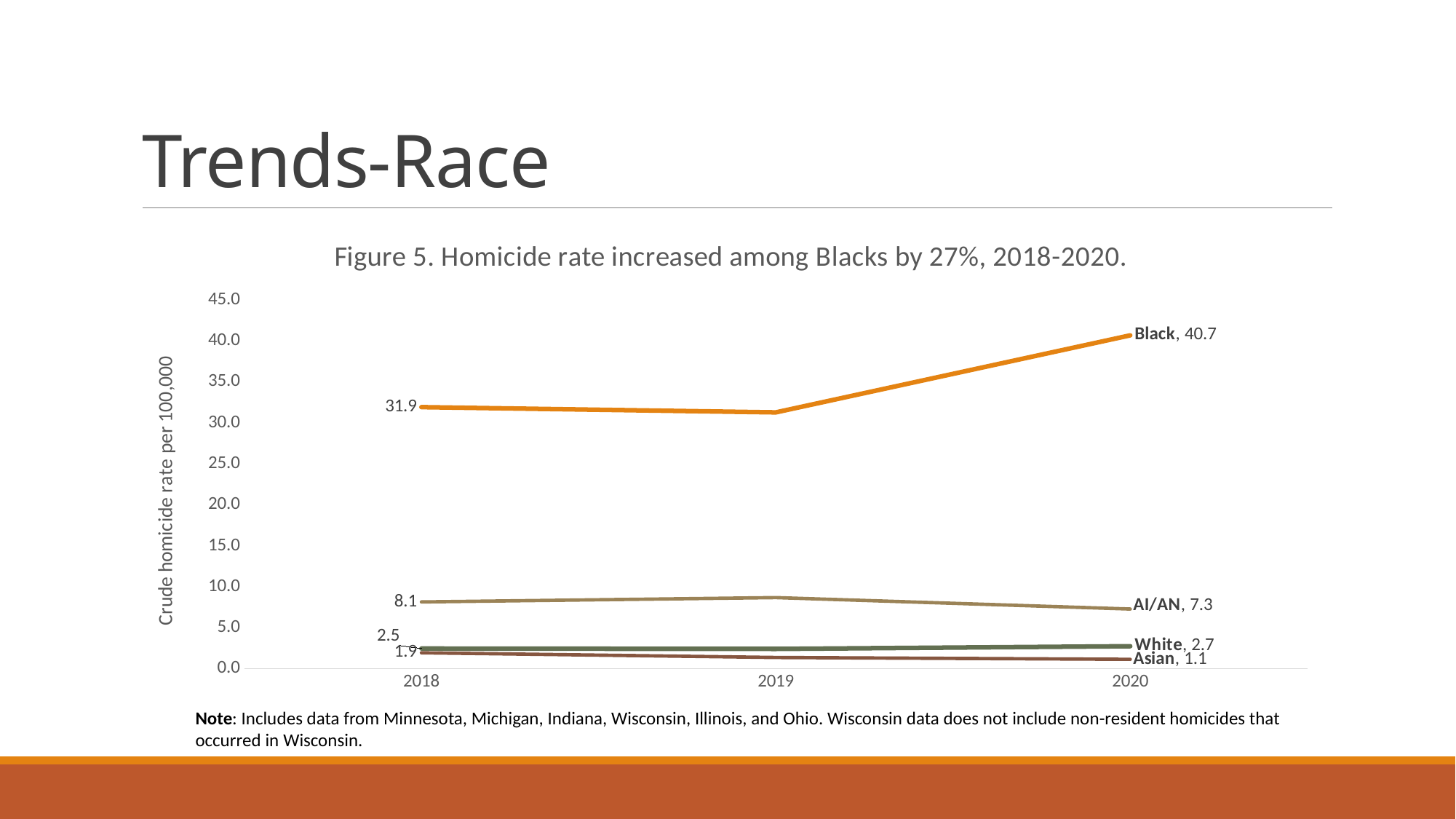
What is the title of the chart? Figure 5. Homicide rate increased among Blacks by 27%, 2018-2020. Is the homicide rate for Black in 2019 greater or less than 35.0? less What is the homicide rate for Asian in 2020? 1.1 What is the homicide rate for Black in 2018? 31.9 What is the homicide rate for White in 2020? 2.7 Which race has the highest homicide rate in 2020? Black What is the homicide rate for AI/AN in 2020? 7.3 What type of chart is shown on the slide? line chart By how much did the homicide rate for Black change from 2018 to 2020? 8.8 What is the homicide rate for Black in 2020? 40.7 Which race has the lowest homicide rate in 2020? Asian How many years are shown on the x axis? 3